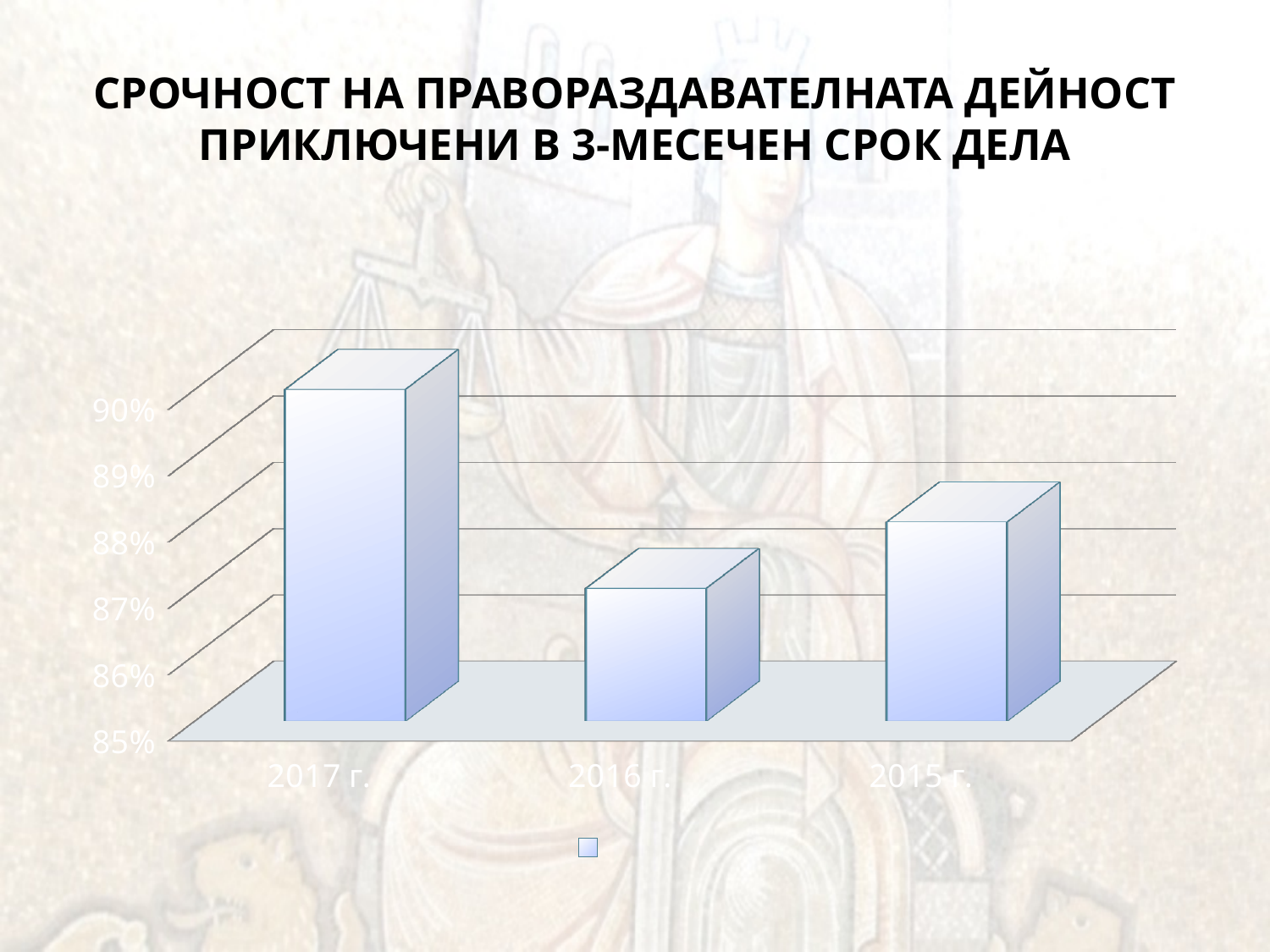
What kind of chart is shown on the slide? bar chart How many categories (years) are plotted on the chart? 3 Which year has the lowest bar on the chart? 2016 г. Which is larger, the value for 2017 г. or the value for 2016 г.? 2017 г. Is the value for 2016 г. greater or less than 86%? greater Which is larger, the value for 2015 г. or the value for 2016 г.? 2015 г. Which year has the highest bar on the chart? 2017 г. Is the value for 2015 г. greater or less than 87%? greater What is the lowest value labelled on the vertical axis of the chart? 85% Is the value for 2017 г. greater or less than 89%? greater What is the title of the slide containing the chart? СРОЧНОСТ НА ПРАВОРАЗДАВАТЕЛНАТА ДЕЙНОСТ ПРИКЛЮЧЕНИ В 3-МЕСЕЧЕН СРОК ДЕЛА